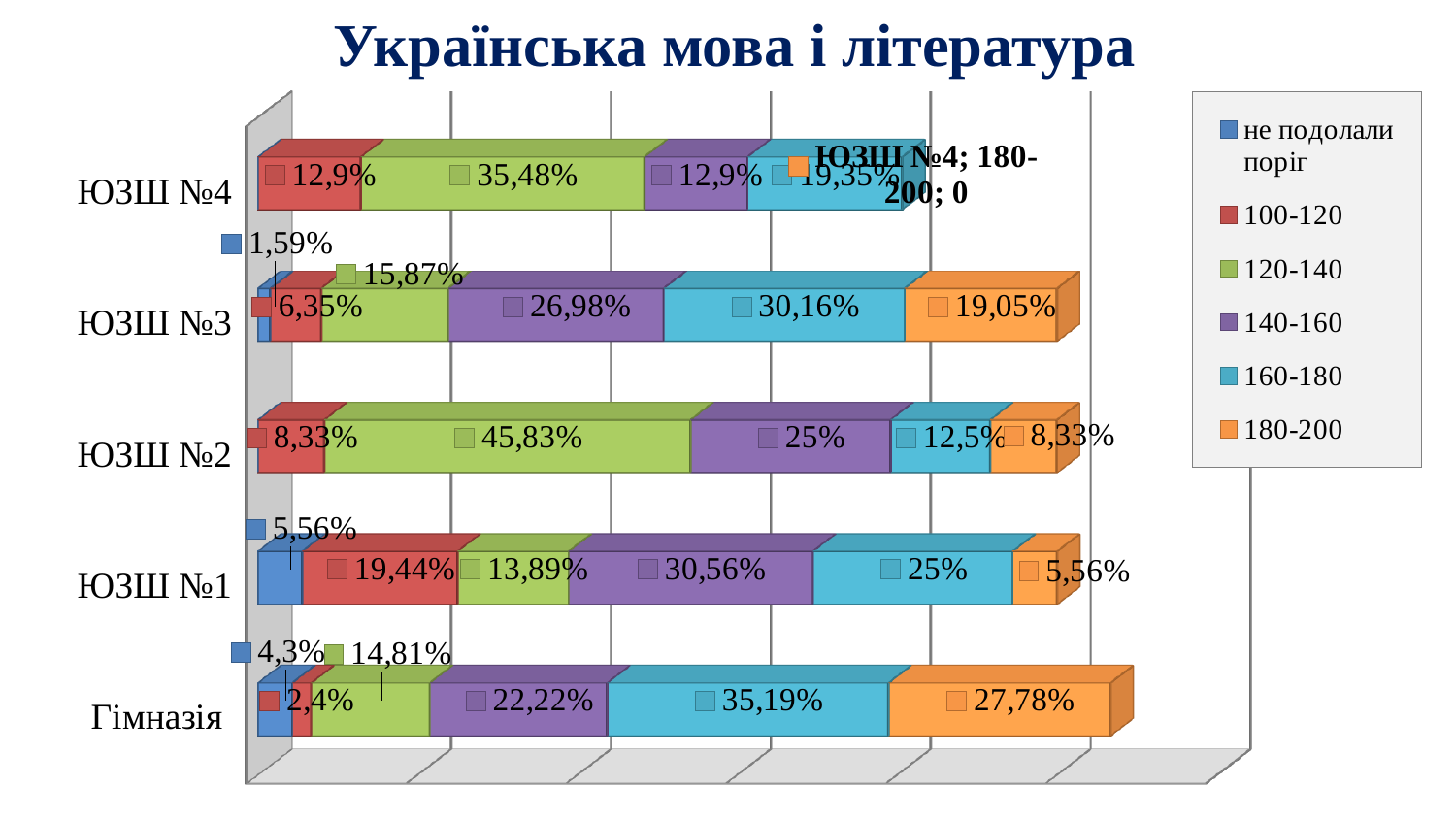
What is the title of the chart? Українська мова і література How many schools (categories) are shown on the chart? 5 Which school has the lowest value in the 100-120 series? Гімназія Which is larger: the 160-180 value for Гімназія or for ЮЗШ №4? Гімназія Which school has the highest value in the 180-200 series? Гімназія What kind of chart is shown on the slide? Stacked bar chart What is the value of the 160-180 series for ЮЗШ №3? 30,16% What is the difference between the 140-160 values for ЮЗШ №1 and ЮЗШ №2? 5,56% What is the value of the 180-200 series for Гімназія? 27,78% How many series does the legend list? 6 What is the value of the 'не подолали поріг' series for ЮЗШ №1? 5,56% What is the value of the 120-140 series for ЮЗШ №2? 45,83%